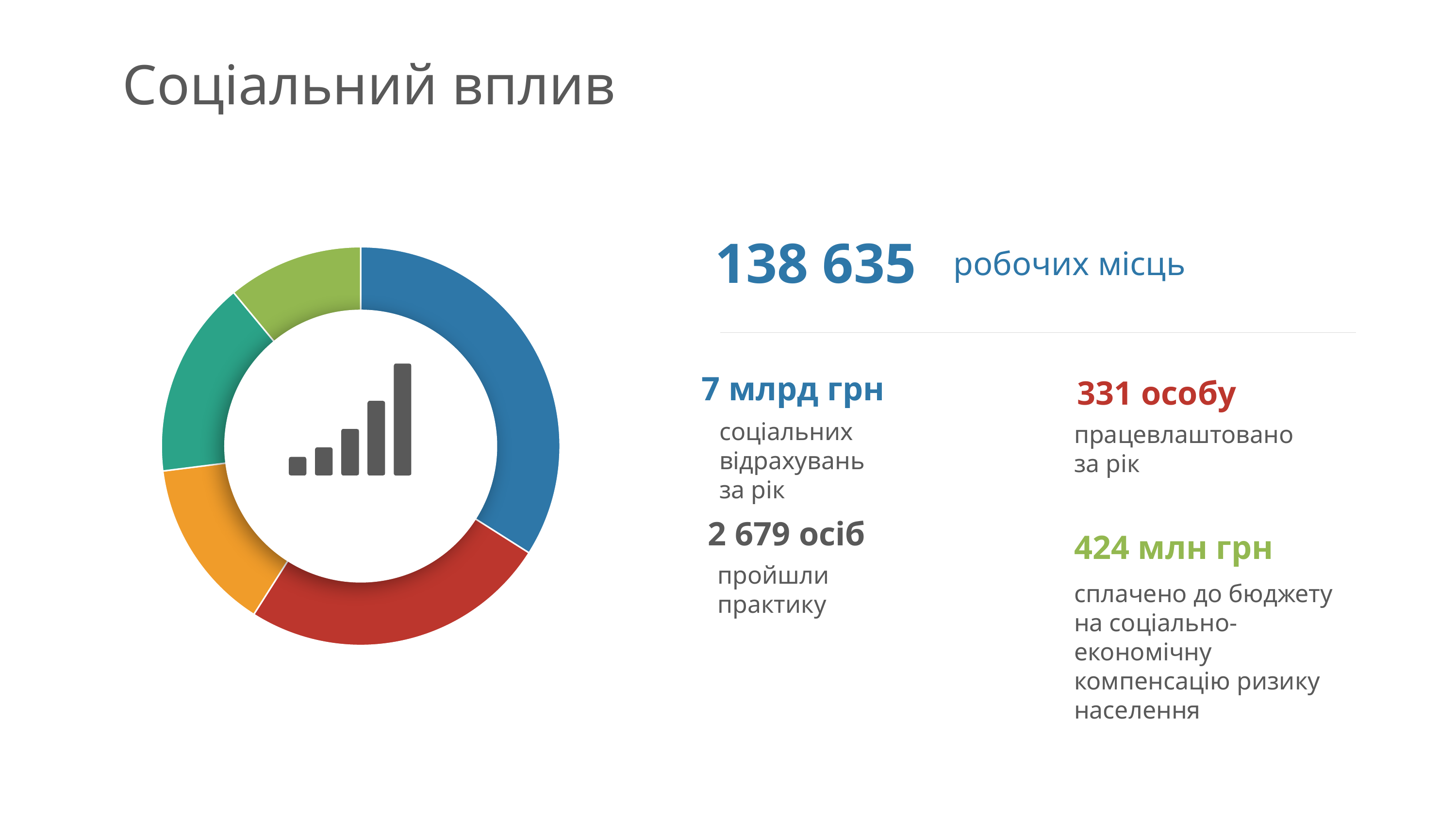
Which colour segment of the donut chart is the largest? Blue In the donut chart, which segment is larger, the blue one or the red one? Blue What kind of chart is shown on the left of the slide? Donut (pie) chart What is the title of the slide containing the donut chart? Соціальний вплив How many segments does the donut chart on the left have? 5 What icon is shown in the centre of the donut chart? A bar chart icon In the donut chart, which segment is larger, the blue one or the green one? Blue